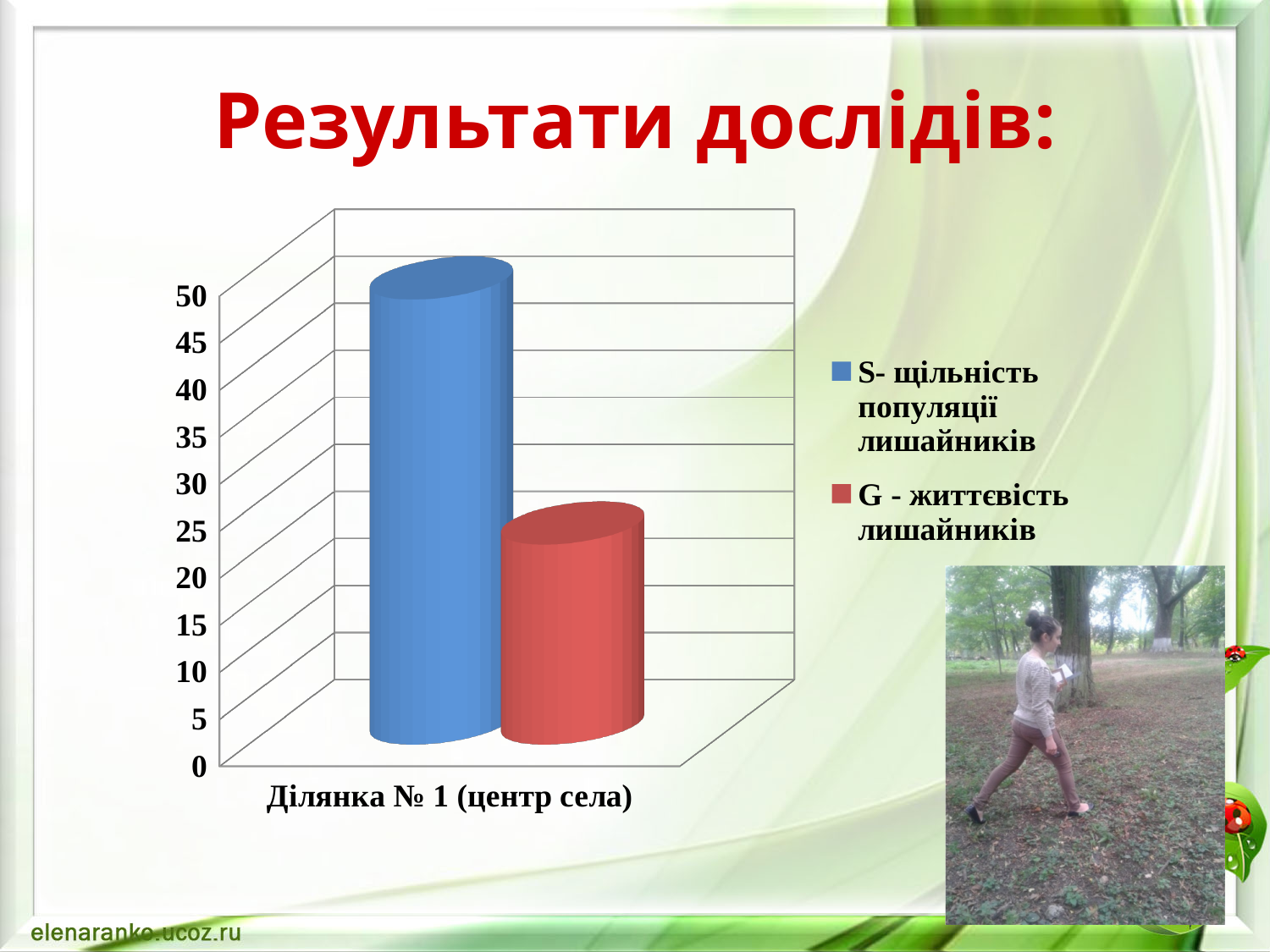
How many categories are shown on the x axis of the chart? 1 Which series has the lowest value in the chart? G - життєвість лишайників Which series has the larger value for Ділянка № 1 (центр села): S- щільність популяції лишайників or G - життєвість лишайників? S- щільність популяції лишайників Is the value for G - життєвість лишайників greater or less than 10? greater How many series does the chart legend list? 2 Which series has the highest value in the chart? S- щільність популяції лишайників Which series is represented by the blue bar? S- щільність популяції лишайників What kind of chart is shown on the slide? bar chart Is the value for G - життєвість лишайників greater or less than 40? less What is the label of the category on the x axis? Ділянка № 1 (центр села) Is the value for S- щільність популяції лишайників greater or less than 30? greater